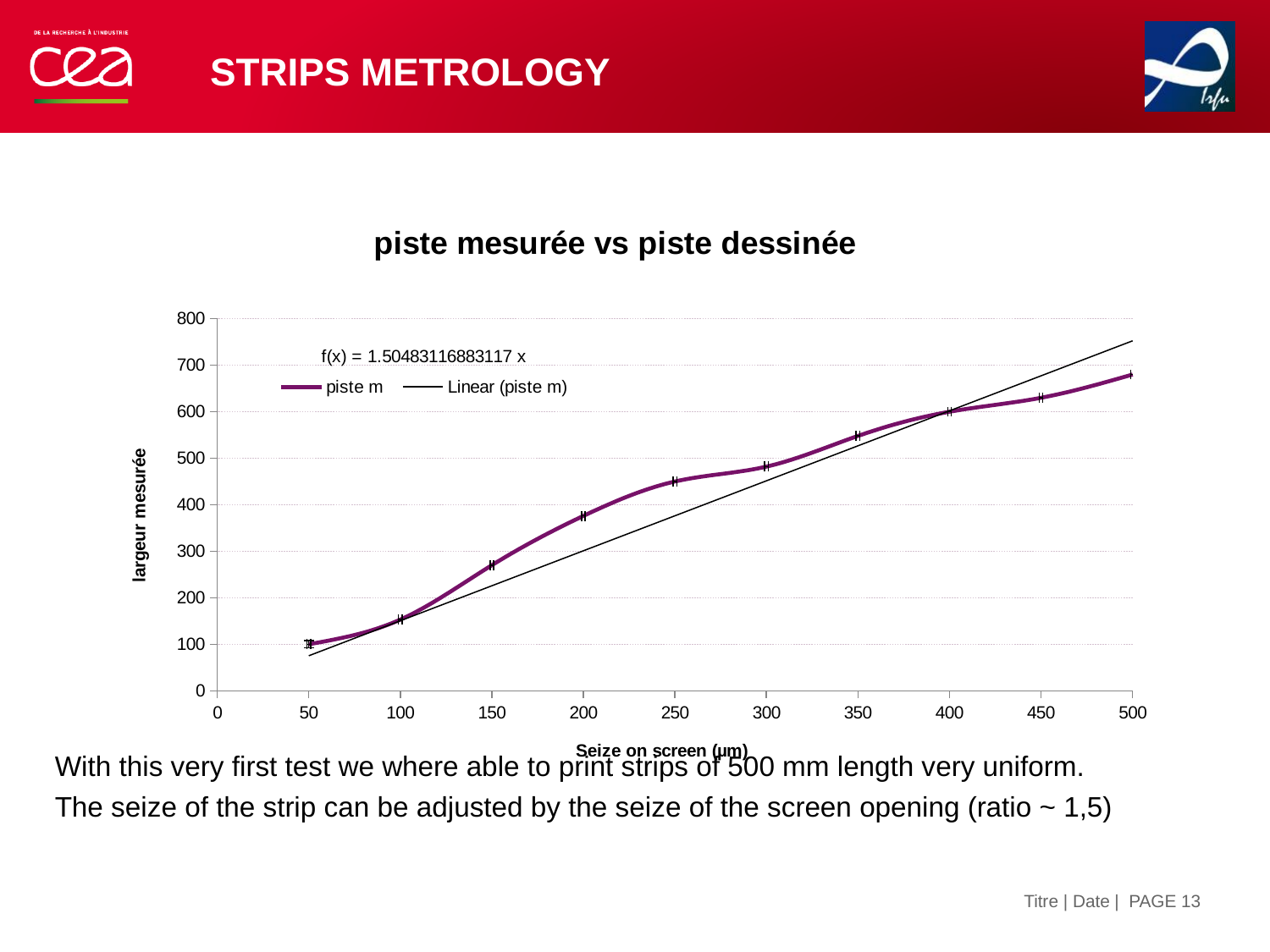
What equation is displayed for the linear trendline on the chart? f(x) = 1.50483116883117 x Do the 'piste m' values rise or fall as the seize on screen increases? rise At which seize on screen value is the measured width ('piste m') highest? 500 At which seize on screen value is the measured width ('piste m') lowest? 50 How many data points are plotted for the 'piste m' series? 10 How many series does the chart legend list? 2 Which has the larger 'piste m' value: a seize on screen of 300 or 350? 350 What is the title of the chart? piste mesurée vs piste dessinée Is the 'piste m' value at a seize on screen of 250 greater or less than 400? greater Is the 'piste m' value at a seize on screen of 200 greater or less than 300? greater What kind of chart is shown on the slide? line chart Is the 'piste m' value at a seize on screen of 150 greater or less than 300? less